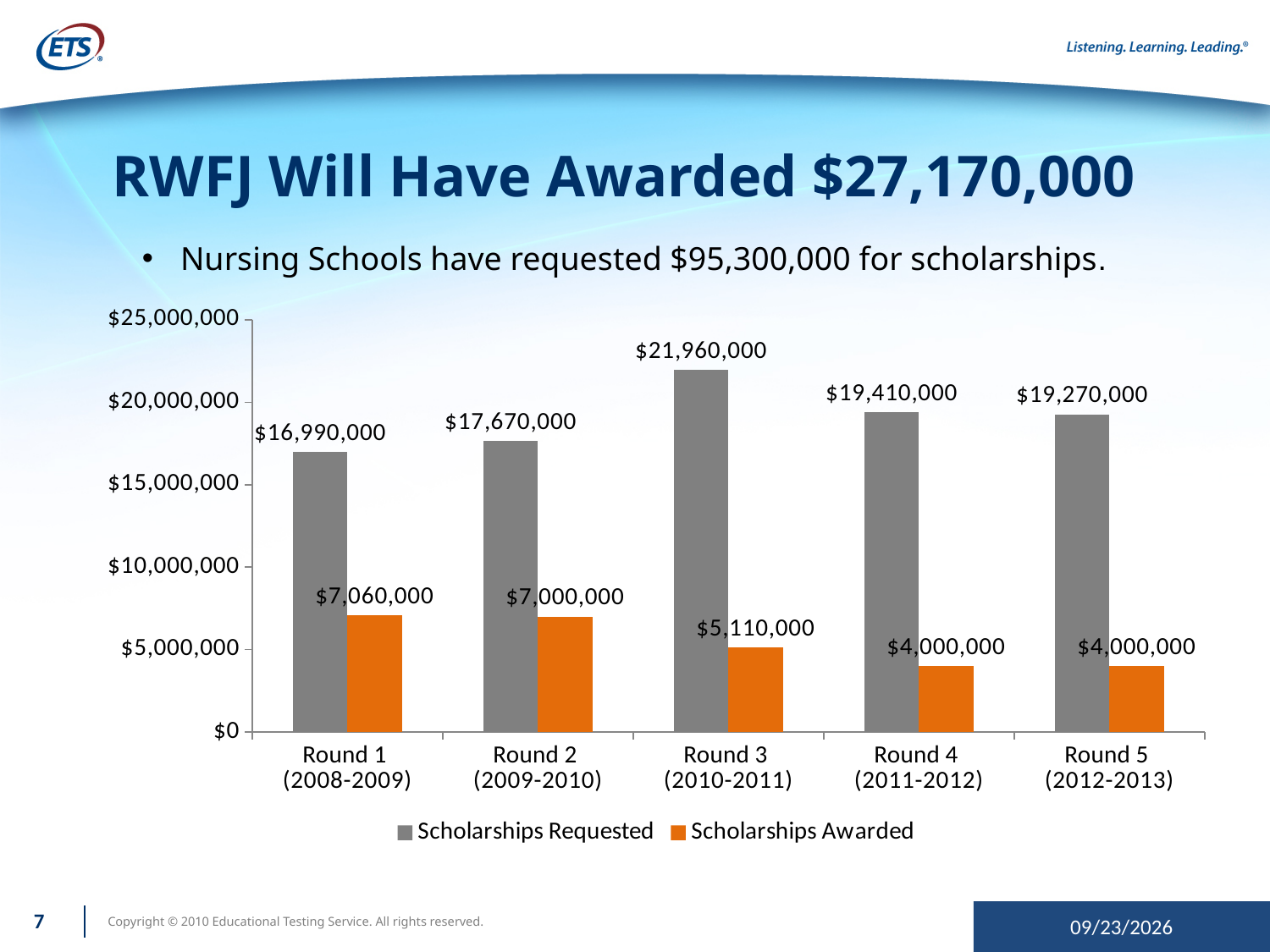
Which is larger: Scholarships Requested in Round 4 (2011-2012) or in Round 5 (2012-2013)? Round 4 (2011-2012) How many rounds are shown on the x axis? 5 What is the value of Scholarships Requested for Round 3 (2010-2011)? $21,960,000 What is the value of Scholarships Awarded for Round 3 (2010-2011)? $5,110,000 Which colour represents Scholarships Awarded in the chart? Orange Is the value of Scholarships Awarded for Round 4 (2011-2012) greater or less than $5,000,000? less Which round has the highest value for Scholarships Requested? Round 3 (2010-2011) Which round has the lowest value for Scholarships Requested? Round 1 (2008-2009) What is the value of Scholarships Awarded for Round 1 (2008-2009)? $7,060,000 What kind of chart is shown on the slide? Bar chart How many series does the legend list? 2 What is the difference between Scholarships Requested and Scholarships Awarded in Round 2 (2009-2010)? $10,670,000